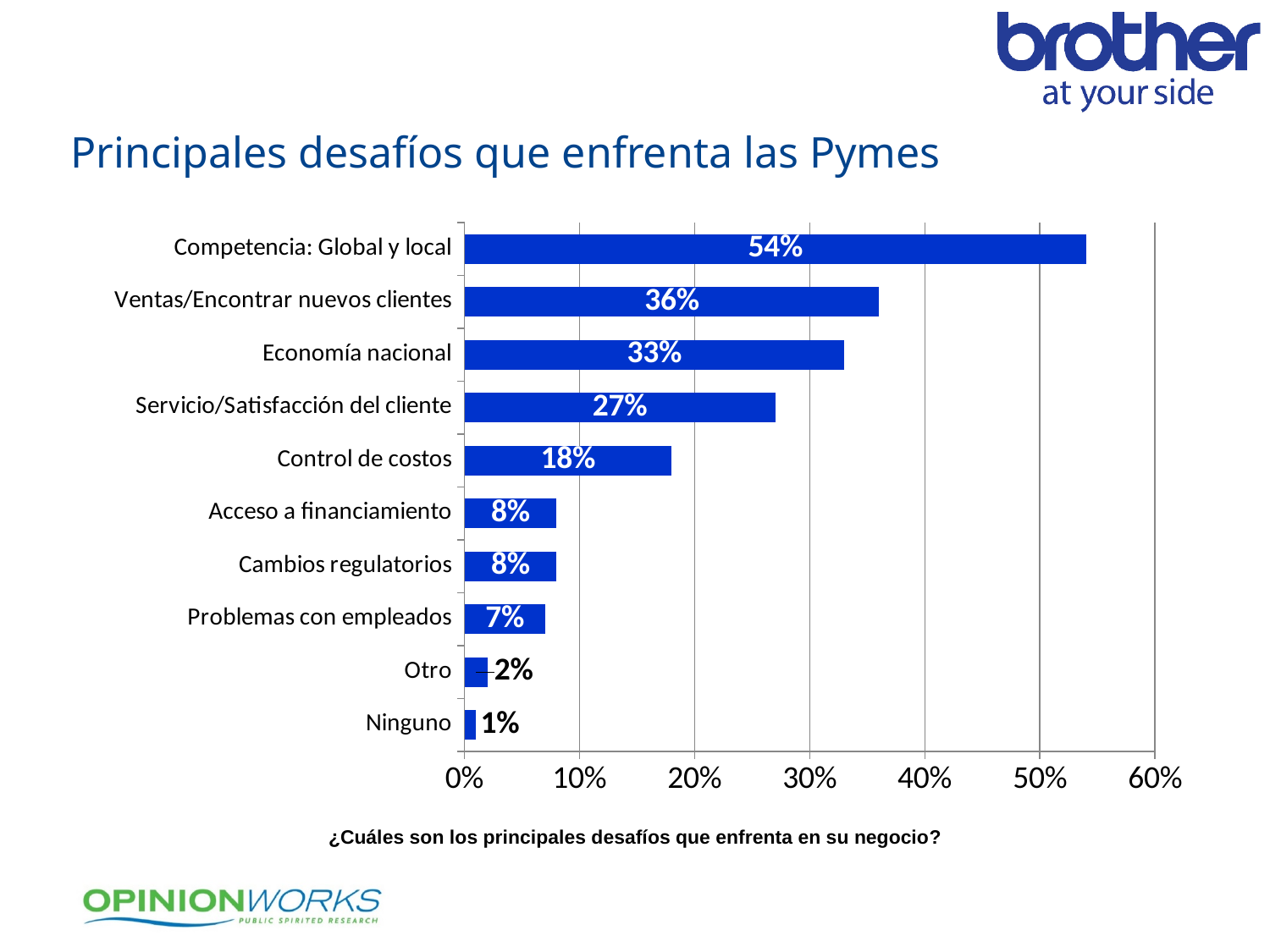
What is the value for Problemas con empleados? 7% What is the difference between Ventas/Encontrar nuevos clientes and Servicio/Satisfacción del cliente? 9% Is the value for Servicio/Satisfacción del cliente greater or less than 20%? greater What is the value for Competencia: Global y local? 54% What is the value for Control de costos? 18% What kind of chart is shown on the slide? bar chart Which category has the lowest value? Ninguno How many categories are shown in the chart? 10 Which is larger, Economía nacional or Control de costos? Economía nacional Which category has the highest value? Competencia: Global y local What is the value for Economía nacional? 33% What is the title of the slide? Principales desafíos que enfrenta las Pymes